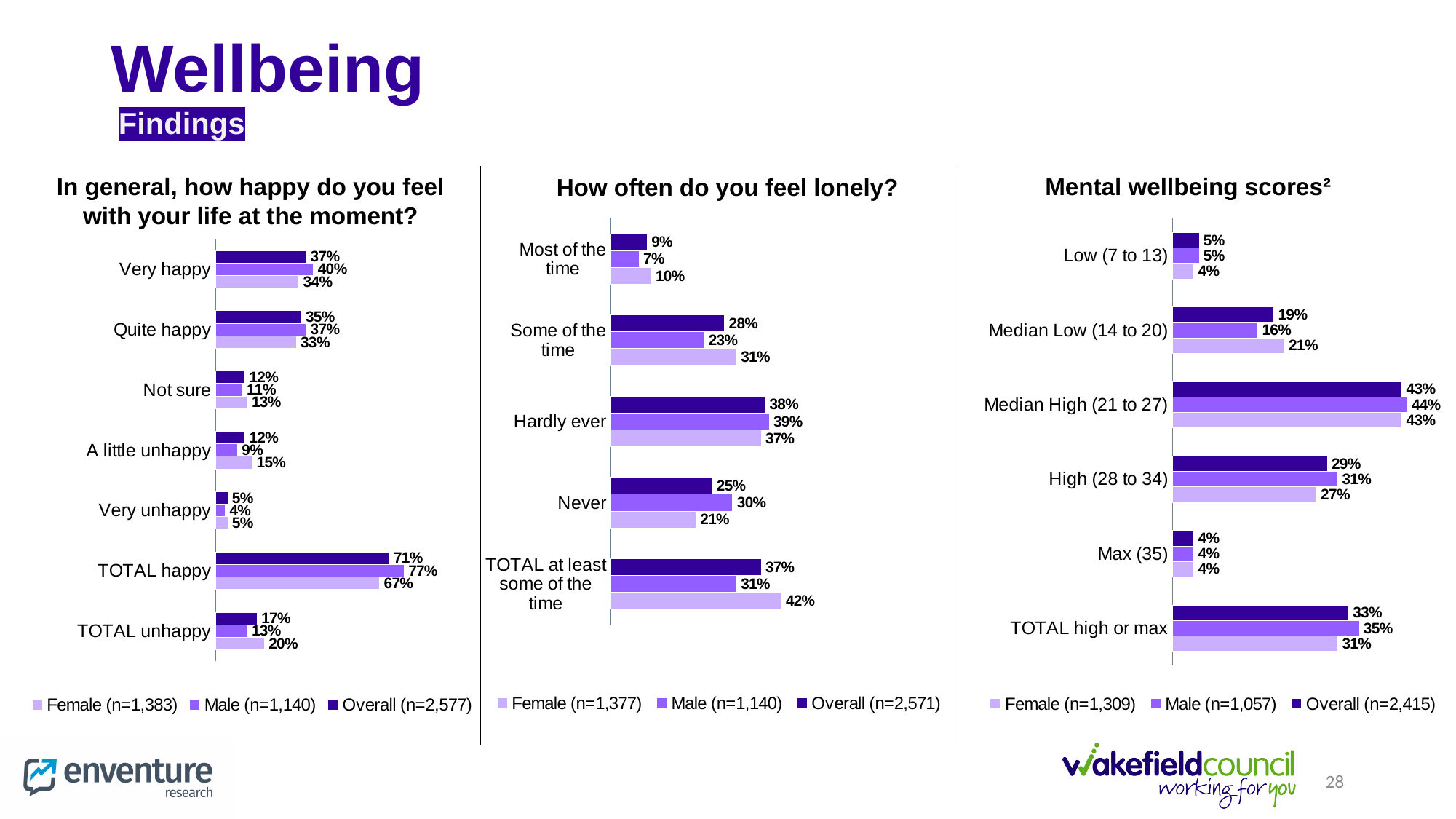
In the 'Mental wellbeing scores²' chart, what is the difference between the Male and Female values for 'High (28 to 34)'? 4% In the 'In general, how happy do you feel with your life at the moment?' chart, what is the difference between the Male and Female values for 'TOTAL happy'? 10% In the 'Mental wellbeing scores²' chart, what is the Female value for 'Median Low (14 to 20)'? 21% In the 'In general, how happy do you feel with your life at the moment?' chart, how many series does the legend list? 3 In the 'In general, how happy do you feel with your life at the moment?' chart, what is the Female value for 'TOTAL happy'? 67% In the 'How often do you feel lonely?' chart, what is the Overall value for 'Hardly ever'? 38% In the 'In general, how happy do you feel with your life at the moment?' chart, what is the Male value for 'Very happy'? 40% In the 'How often do you feel lonely?' chart, which category has the lowest Overall value? Most of the time In the 'How often do you feel lonely?' chart, what is the Female value for 'TOTAL at least some of the time'? 42% What kind of chart is the 'Mental wellbeing scores²' chart? Bar chart In the 'How often do you feel lonely?' chart, is the Male value for 'Never' larger or the Female value for 'Never'? Male In the 'Mental wellbeing scores²' chart, which category has the highest Overall value? Median High (21 to 27)